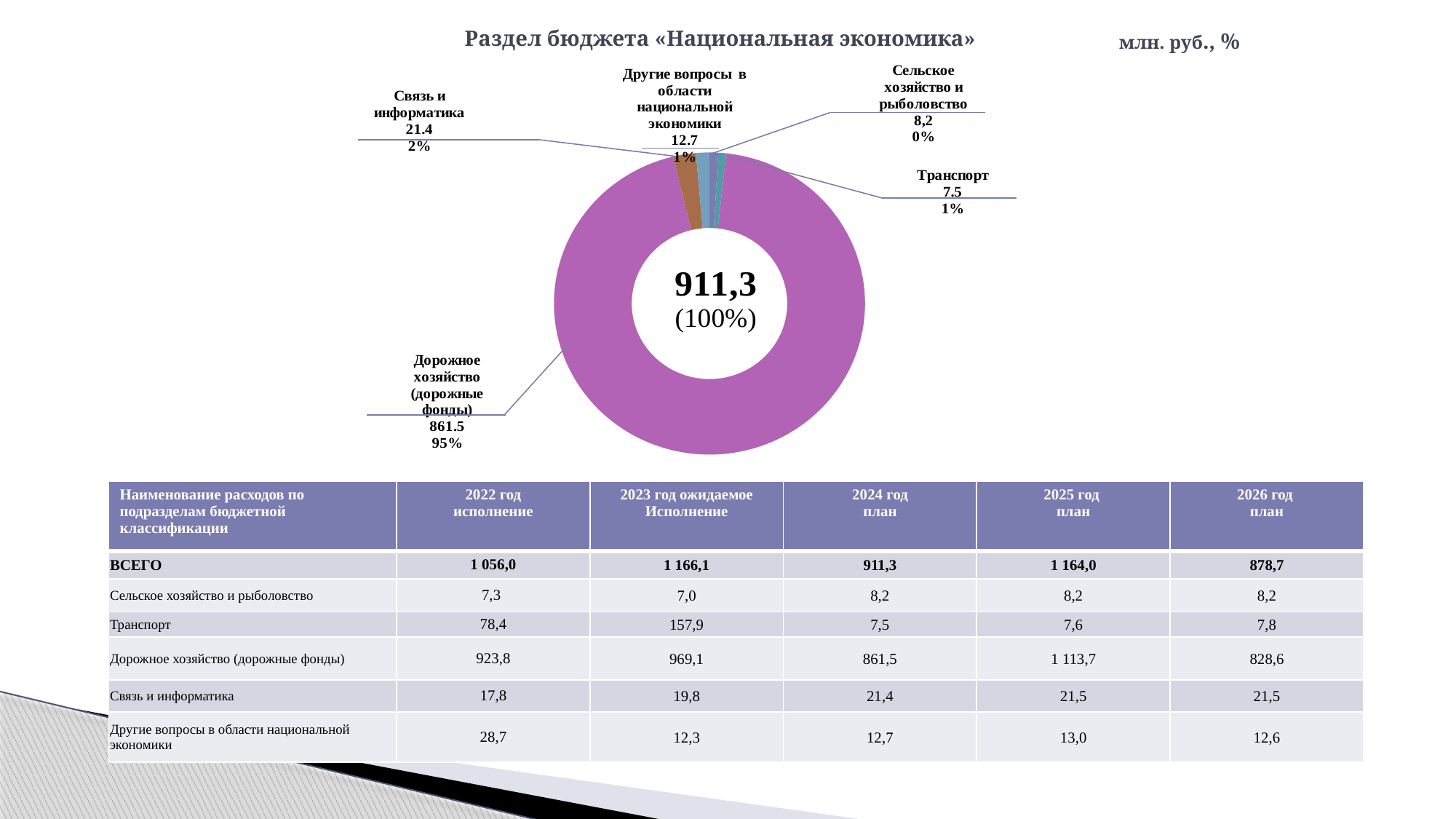
What is the difference between the values for Связь и информатика and Другие вопросы в области национальной экономики? 8.7 What is the value for Связь и информатика in the chart? 21.4 What is the value for Другие вопросы в области национальной экономики in the chart? 12.7 What type of chart is shown on the slide? pie chart (donut) What is the value for Дорожное хозяйство (дорожные фонды) in the chart? 861.5 What is the value for Транспорт in the chart? 7.5 Which category has the largest slice in the chart? Дорожное хозяйство (дорожные фонды) How many categories are shown in the chart? 5 What total value is shown in the centre of the chart? 911,3 Which is larger in the chart: Сельское хозяйство и рыболовство or Транспорт? Сельское хозяйство и рыболовство What share of the chart does Дорожное хозяйство (дорожные фонды) represent? 95% Which category has the smallest slice in the chart? Транспорт